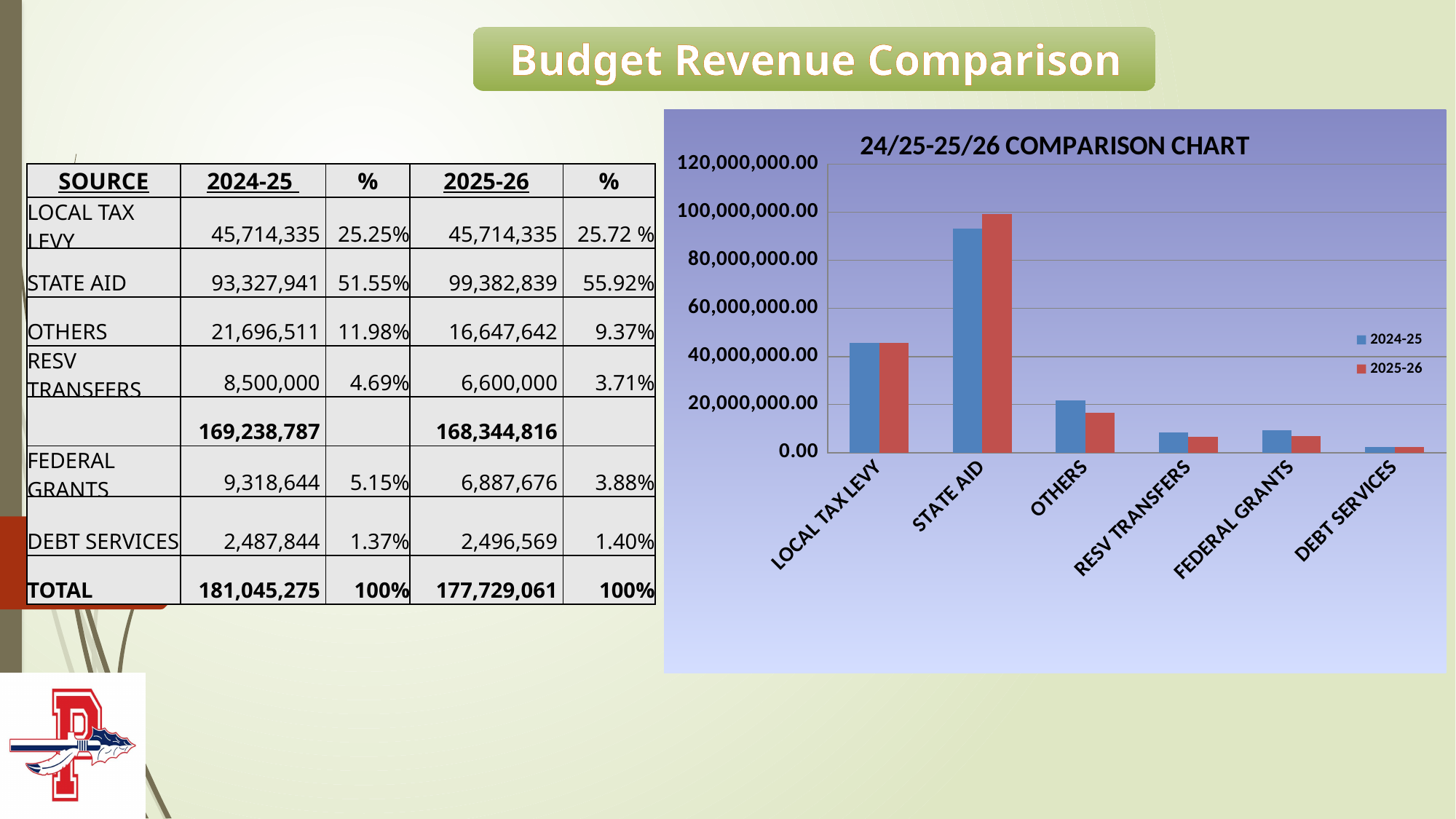
According to the slide, what is the 2025-26 value for STATE AID plotted in the 24/25-25/26 COMPARISON CHART? 99,382,839 In the 24/25-25/26 COMPARISON CHART, which series has the larger bar for STATE AID, 2024-25 or 2025-26? 2025-26 Which category has the tallest bar in the 24/25-25/26 COMPARISON CHART? STATE AID How many categories are shown on the x axis of the 24/25-25/26 COMPARISON CHART? 6 In the 24/25-25/26 COMPARISON CHART, is the 2025-26 value for STATE AID greater or less than 80,000,000.00? greater In the 24/25-25/26 COMPARISON CHART, is the 2024-25 value for LOCAL TAX LEVY greater or less than 60,000,000.00? less In the 24/25-25/26 COMPARISON CHART, is the 2025-26 value for OTHERS greater or less than 20,000,000.00? less How many series does the legend of the 24/25-25/26 COMPARISON CHART list? 2 What is the title of the chart on the slide? 24/25-25/26 COMPARISON CHART In the 24/25-25/26 COMPARISON CHART, which series has the larger bar for OTHERS, 2024-25 or 2025-26? 2024-25 Which category has the lowest bars in the 24/25-25/26 COMPARISON CHART? DEBT SERVICES What kind of chart is the 24/25-25/26 COMPARISON CHART? bar chart